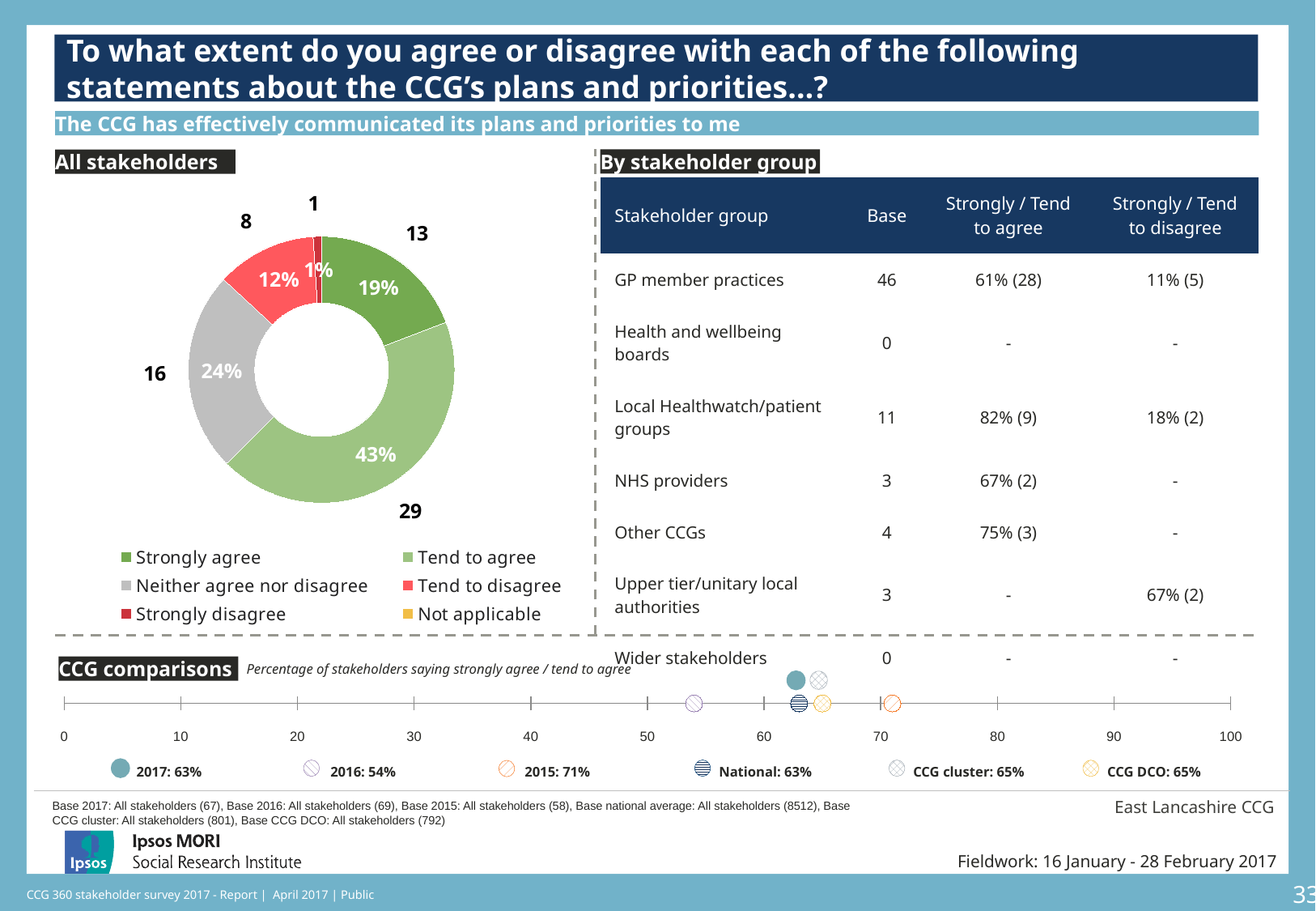
What kind of chart is the All stakeholders chart? Donut (pie) chart In the All stakeholders donut chart, how many stakeholders said 'Neither agree nor disagree'? 16 In the CCG comparisons chart, what percentage of stakeholders said strongly agree / tend to agree in 2016? 54% In the CCG comparisons chart, what is the difference in percentage points between the 2017 and 2016 values? 9 percentage points In the All stakeholders donut chart, which labelled response category has the smallest share? Strongly disagree In the CCG comparisons chart, which marker has the highest value? 2015: 71% In the All stakeholders donut chart, which is larger: 'Neither agree nor disagree' or 'Tend to disagree'? Neither agree nor disagree In the All stakeholders donut chart, what is the difference in percentage points between 'Tend to agree' and 'Strongly agree'? 24 percentage points How many response categories does the legend of the All stakeholders chart list? 6 In the All stakeholders donut chart, which response category has the largest share? Tend to agree In the All stakeholders donut chart, what percentage of stakeholders said 'Strongly agree'? 19% In the All stakeholders donut chart, what percentage of stakeholders said 'Tend to agree'? 43%